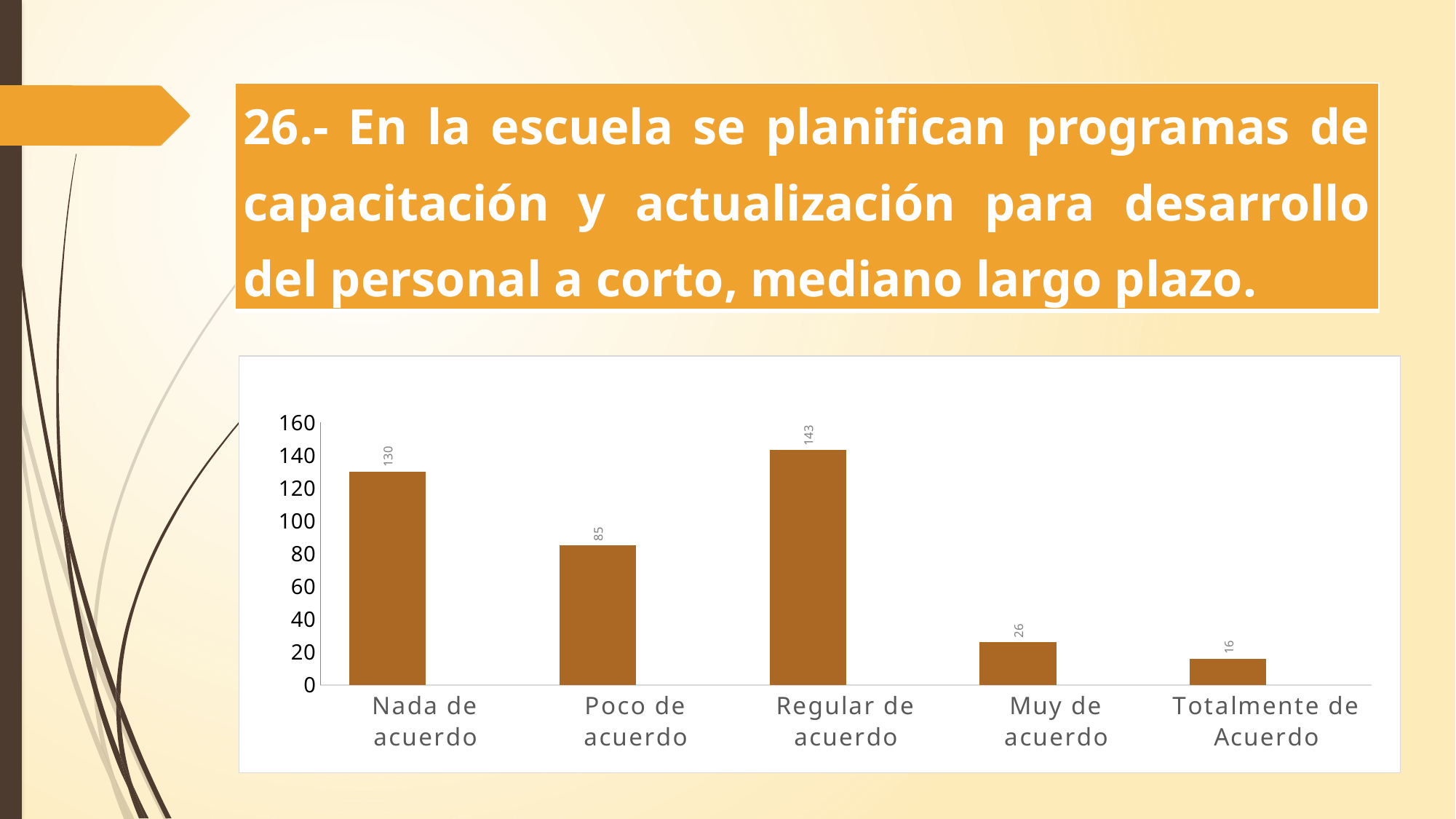
What is the difference between the values for "Regular de acuerdo" and "Nada de acuerdo"? 13 What kind of chart is shown on the slide? bar chart How many categories are shown on the x axis? 5 Is the value for "Poco de acuerdo" greater or less than 100? less What is the value for "Nada de acuerdo"? 130 What is the value for "Totalmente de Acuerdo"? 16 Which category has the lowest value? Totalmente de Acuerdo What is the value for "Poco de acuerdo"? 85 What is the value for "Regular de acuerdo"? 143 Which category has the highest value? Regular de acuerdo What is the value for "Muy de acuerdo"? 26 Which is larger, the value for "Poco de acuerdo" or the value for "Muy de acuerdo"? Poco de acuerdo